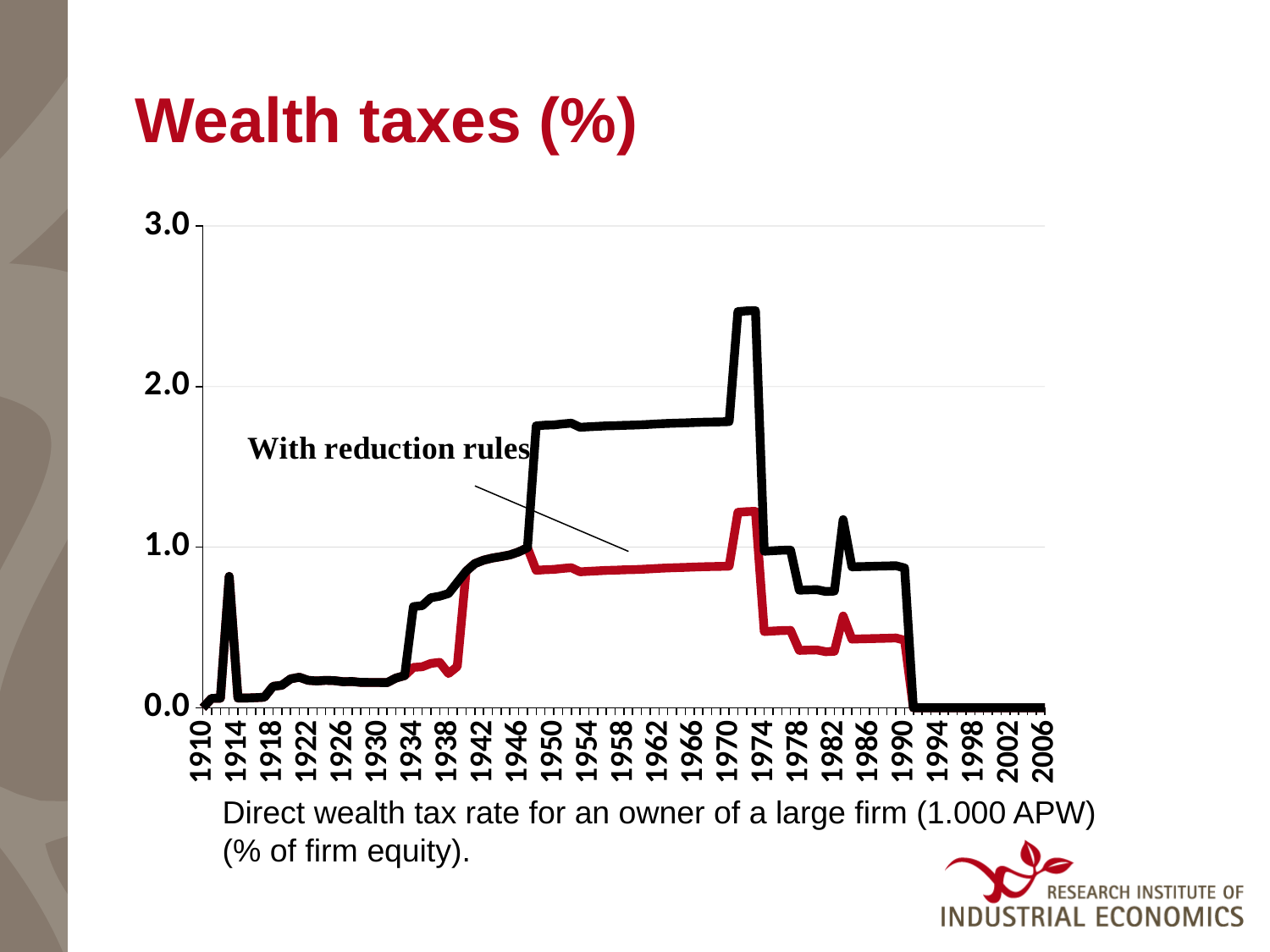
Which line does the annotation "With reduction rules" point to, the red line or the black line? the red line Is the value of the black line in 1960 greater or less than 2.0? less In 1960, which line has the higher value, the black line or the red line? the black line What is the title of the chart? Wealth taxes (%) What kind of chart is shown on the slide? line chart What is the highest value shown on the vertical axis? 3.0 Is the value of the red line in 1960 greater or less than 1.0? less In which decade does the black line reach its highest value? 1970s Do the values of the black line rise or fall between 1990 and 1994? fall Is the peak value of the black line in the early 1970s greater or less than 2.0? greater How many lines are plotted on the chart? 2